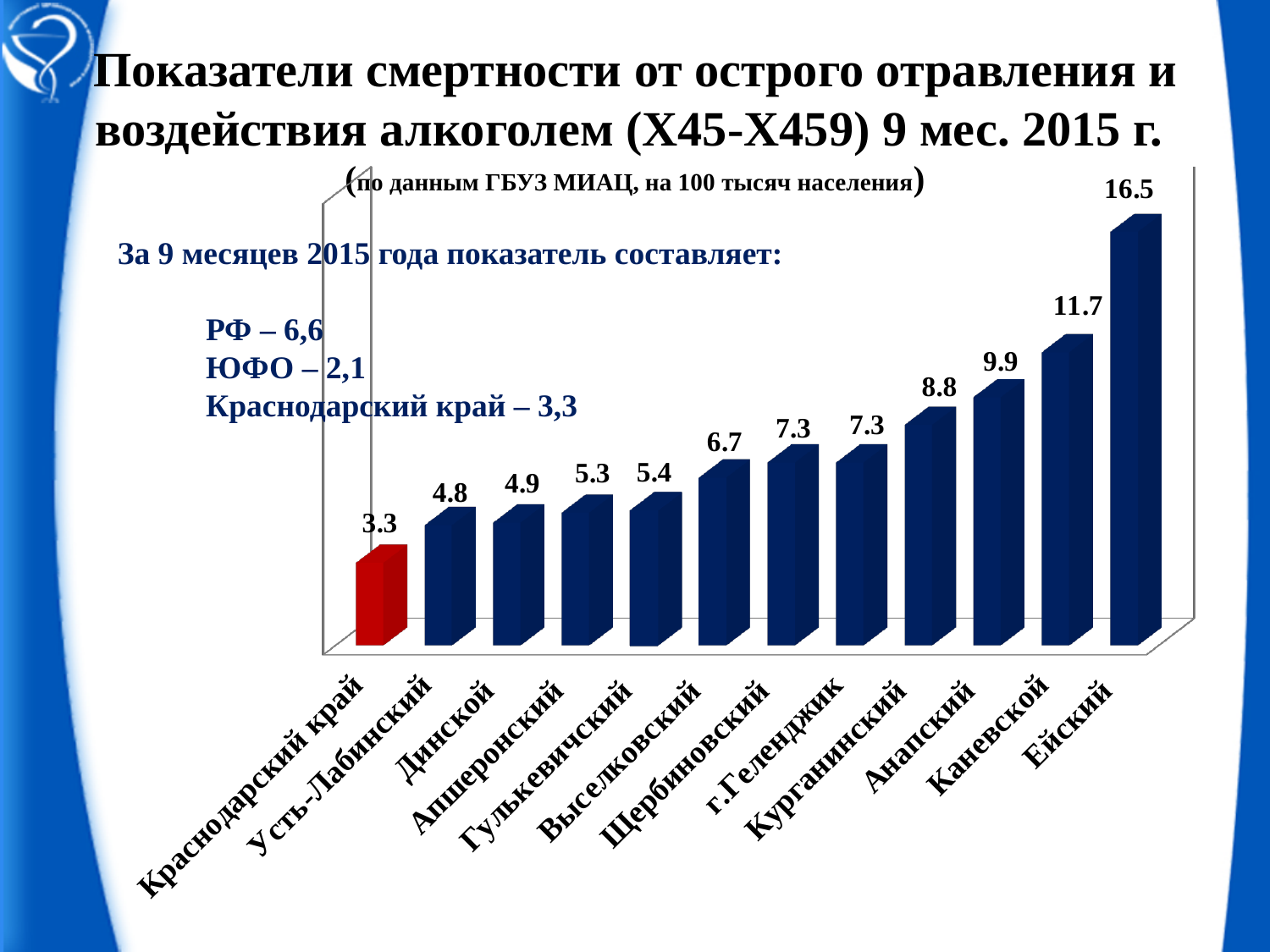
What is the value for Курганинский? 8.8 What is the difference between the values for Анапский and Краснодарский край? 6.6 How many categories are shown on the chart? 12 Which is larger, the value for Каневской or the value for Анапский? Каневской What is the difference between the values for Ейский and Каневской? 4.8 Which bar is coloured red rather than blue? Краснодарский край What is the value for Краснодарский край? 3.3 What is the value for Ейский? 16.5 What is the value for Выселковский? 6.7 Which category has the highest value? Ейский What kind of chart is shown on the slide? Bar chart Which category has the lowest value? Краснодарский край